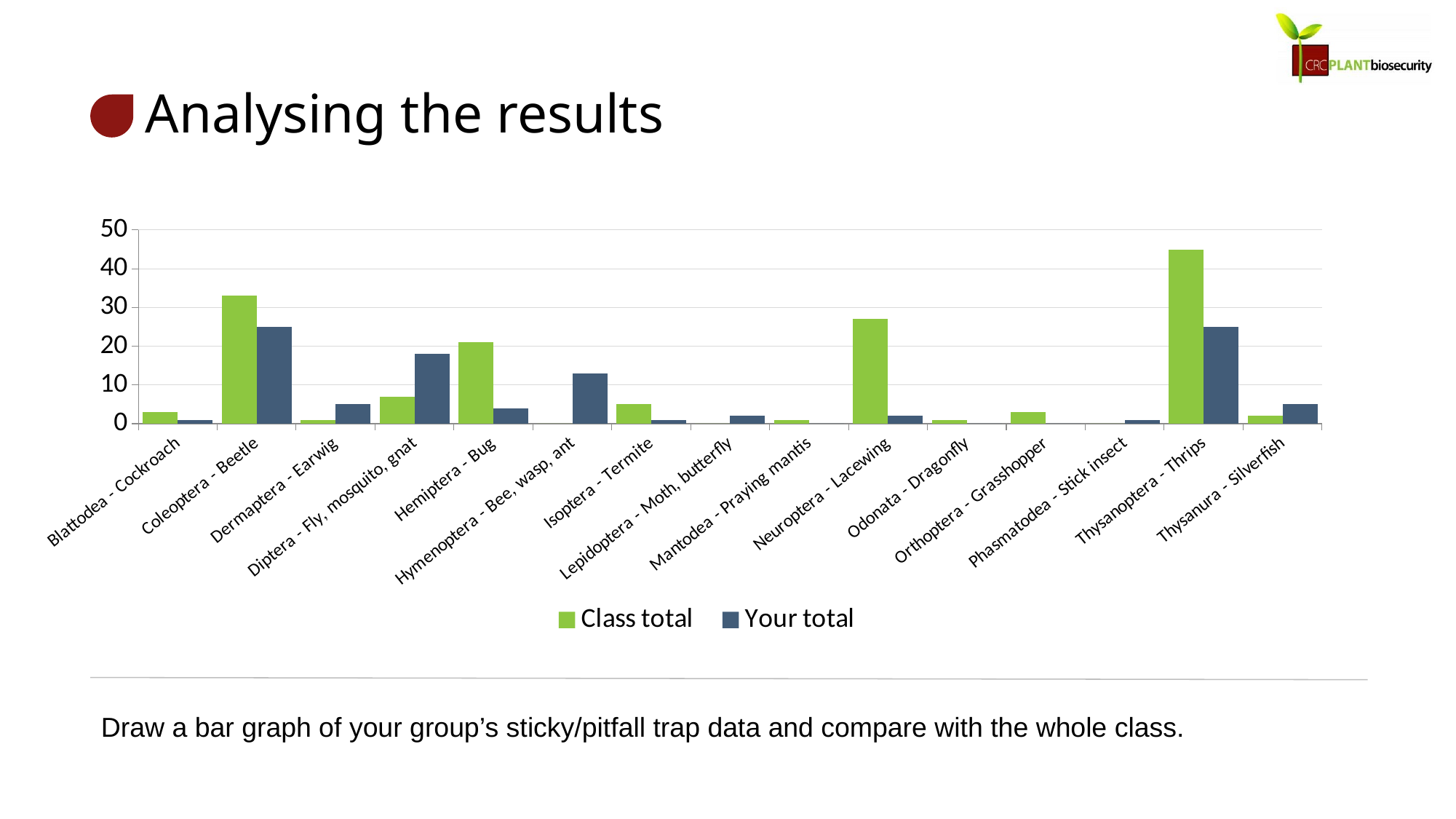
Is the Class total for Thysanoptera - Thrips greater or less than 40? greater Is the Your total value for Hymenoptera - Bee, wasp, ant greater or less than 10? greater Which category has the highest Class total? Thysanoptera - Thrips Is the Class total for Neuroptera - Lacewing greater or less than 20? greater For Coleoptera - Beetle, which is larger: Class total or Your total? Class total How many insect order categories are shown on the x axis? 15 How many series does the legend list? 2 For Diptera - Fly, mosquito, gnat, which is larger: Class total or Your total? Your total Which series is shown in green in the legend? Class total What kind of chart is shown on the slide? bar chart